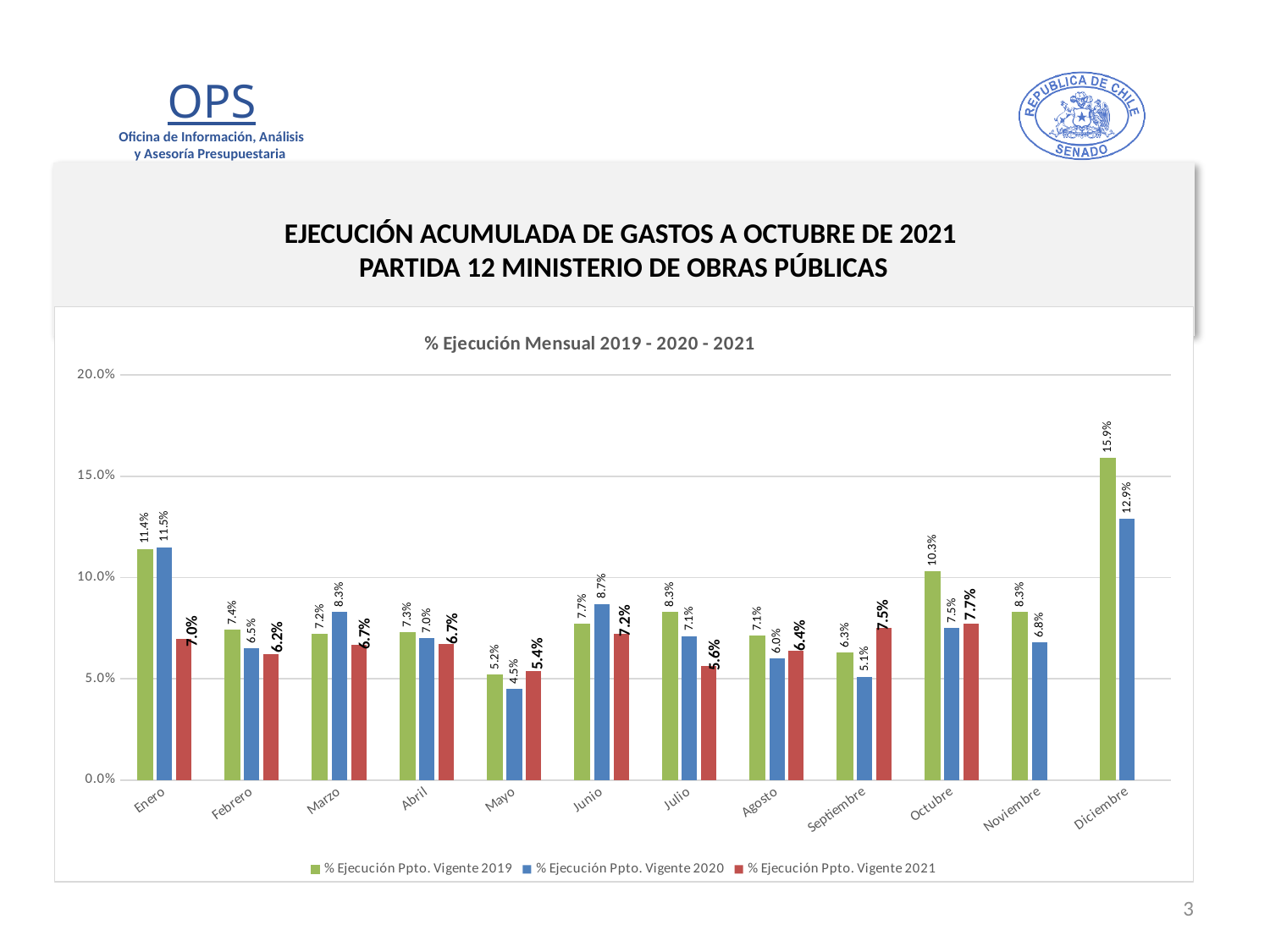
What is the value for Diciembre in the % Ejecución Ppto. Vigente 2019 series? 15.9% What is the title of the chart? % Ejecución Mensual 2019 - 2020 - 2021 Which is larger for Junio: the 2019 value or the 2020 value? 2020 Which month has the lowest value in the % Ejecución Ppto. Vigente 2020 series? Mayo Is the value for Enero in the 2019 series greater or less than 10.0%? greater What kind of chart is shown on the slide? Bar chart How many series does the legend list? 3 How many months are shown on the x axis? 12 What is the value for Mayo in the % Ejecución Ppto. Vigente 2020 series? 4.5% What is the difference between the 2019 and 2020 values for Diciembre? 3.0% What is the value for Septiembre in the % Ejecución Ppto. Vigente 2021 series? 7.5% Which month has the highest value in the % Ejecución Ppto. Vigente 2021 series? Octubre